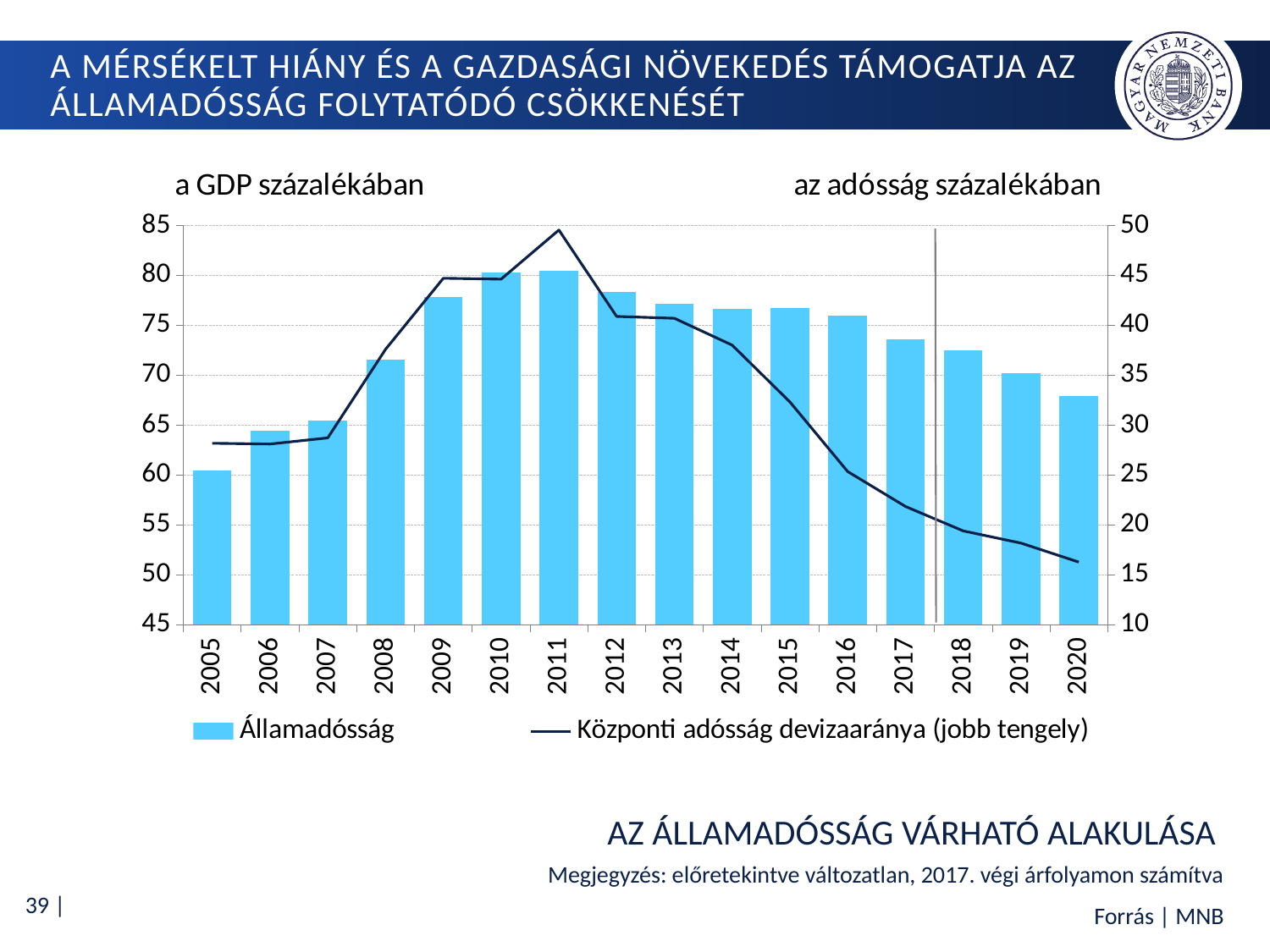
Is the Központi adósság devizaaránya value for 2011 greater or less than 45 on the right axis? greater Is the Államadósság value for 2005 greater or less than 65? less Is the Államadósság value for 2020 greater or less than 70? less Does the Központi adósság devizaaránya line rise or fall from 2011 to 2020? fall Which year has the lowest Államadósság bar? 2005 How many series does the legend list? 2 How many years are shown on the x axis? 16 Which is larger, the Államadósság bar for 2007 or for 2008? 2008 In which year does the Központi adósság devizaaránya line reach its highest point? 2011 What is the label of the left vertical axis? a GDP százalékában